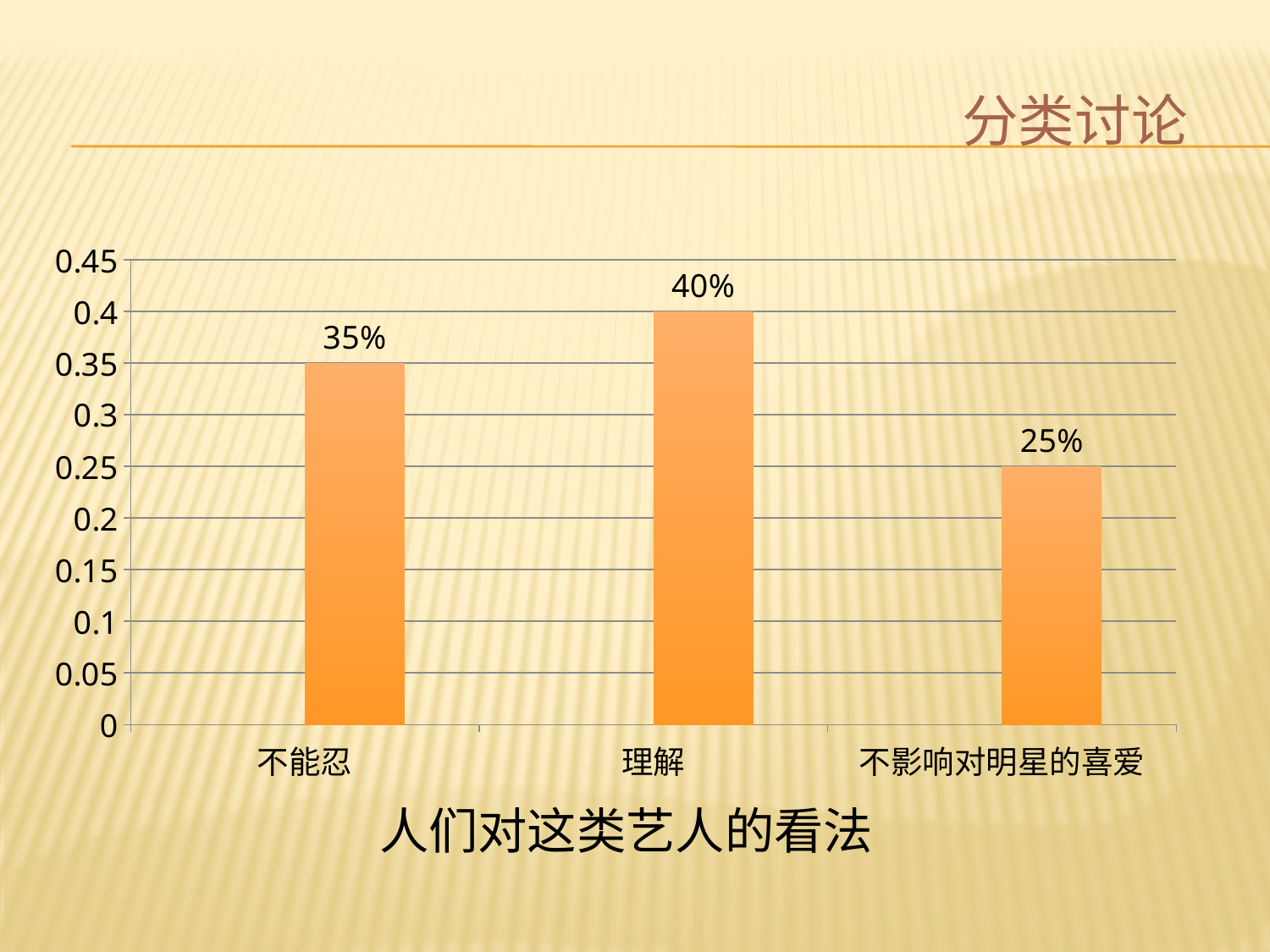
Is the value for 理解 greater or less than 0.3? greater What is the value for 不影响对明星的喜爱? 25% Which is larger, the value for 不能忍 or the value for 不影响对明星的喜爱? 不能忍 What is the difference between the values for 不能忍 and 不影响对明星的喜爱? 10% What kind of chart is shown on the slide? bar chart What is the value for 理解? 40% Which category has the highest value? 理解 What is the title of the chart? 人们对这类艺人的看法 What is the difference between the values for 理解 and 不能忍? 5% Which category has the lowest value? 不影响对明星的喜爱 How many categories are shown on the x axis? 3 What is the value for 不能忍? 35%